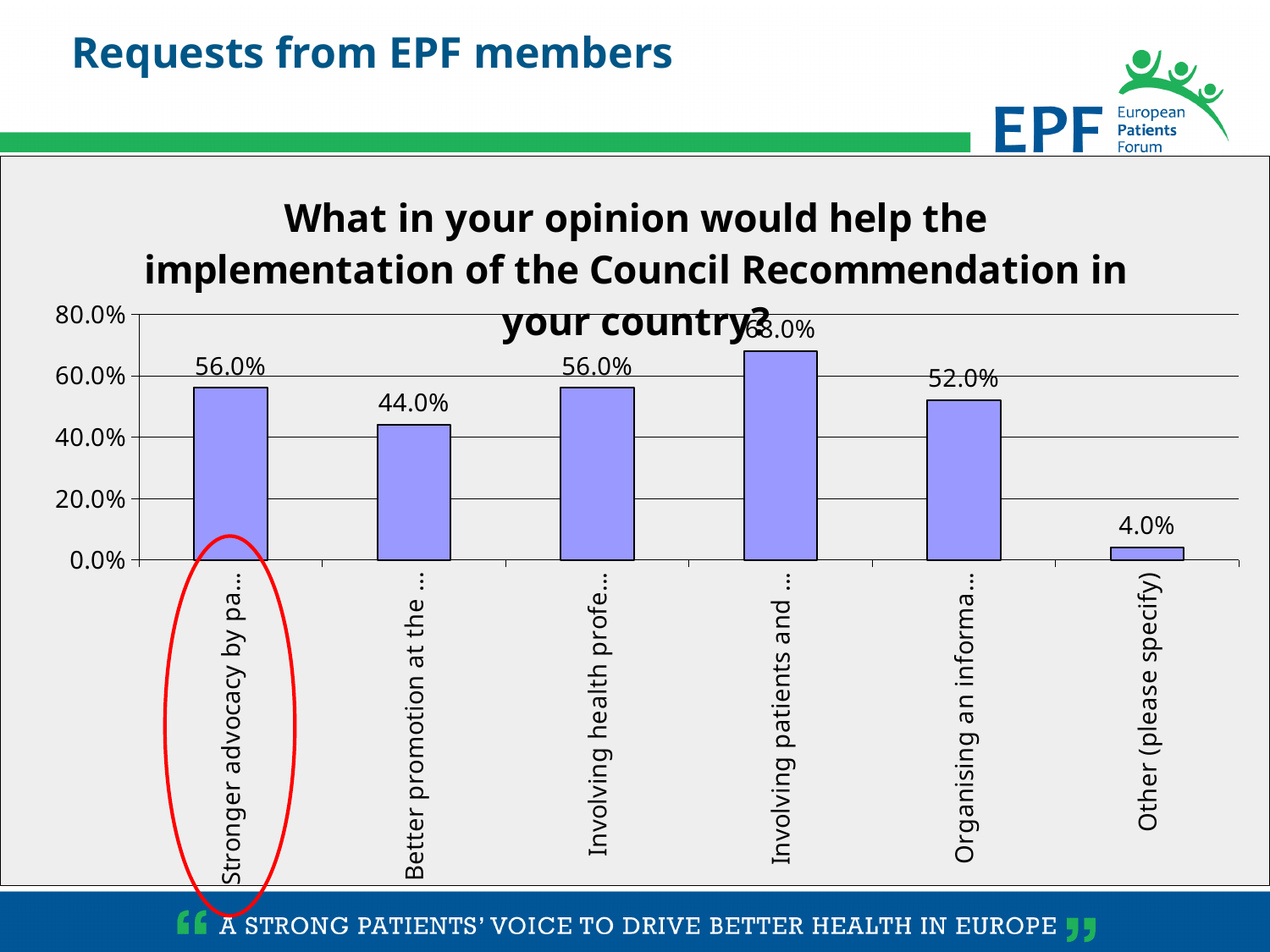
What is the value for "Better promotion at the ..."? 44.0% What is the value for "Stronger advocacy by pa..."? 56.0% What is the value for "Organising an informa..."? 52.0% What kind of chart is shown on the slide? bar chart What is the difference between the values for "Organising an informa..." and "Other (please specify)"? 48.0% What is the difference between the values for "Stronger advocacy by pa..." and "Better promotion at the ..."? 12.0% Which is larger, the value for "Organising an informa..." or the value for "Better promotion at the ..."? Organising an informa... What is the value for "Other (please specify)"? 4.0% Is the value for "Involving patients and ..." greater or less than 60.0%? greater Which category has the highest value? Involving patients and ... How many categories are shown in the chart? 6 Which category has the lowest value? Other (please specify)